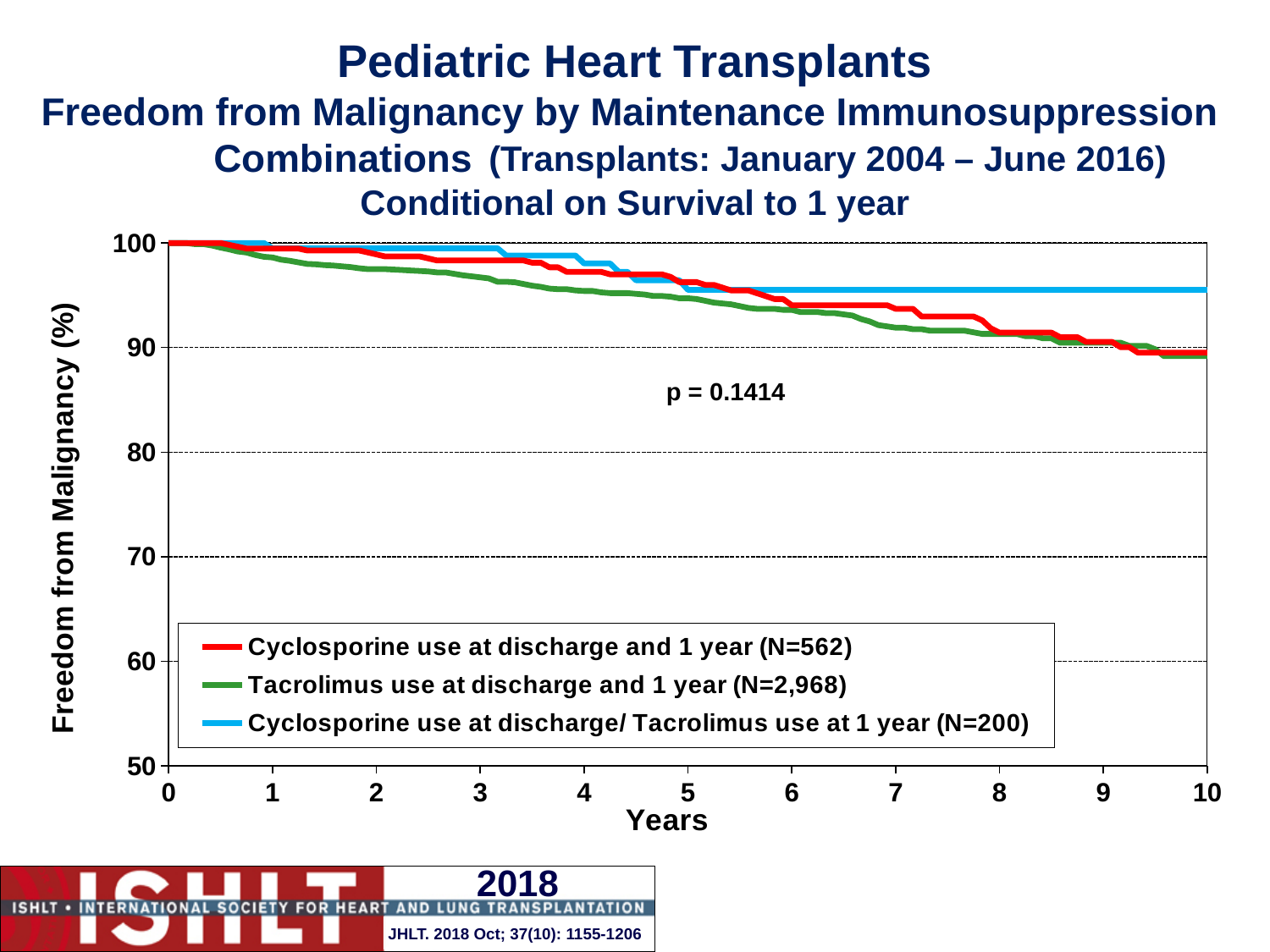
At 8 years, which is higher: the Cyclosporine use at discharge/ Tacrolimus use at 1 year curve or the Tacrolimus use at discharge and 1 year curve? Cyclosporine use at discharge/ Tacrolimus use at 1 year What is the N for the Tacrolimus use at discharge and 1 year group? N=2,968 Which series has the lowest freedom from malignancy at 10 years? Tacrolimus use at discharge and 1 year (N=2,968) How many series does the legend list? 3 What is the label of the x axis? Years Is the freedom from malignancy for the Tacrolimus use at discharge and 1 year group at 10 years greater or less than 90? less What kind of chart is shown on the slide? line chart Do the freedom from malignancy curves rise or fall as years increase? fall What p-value is printed on the chart? p = 0.1414 Is the freedom from malignancy for the Cyclosporine use at discharge/ Tacrolimus use at 1 year group at 10 years greater or less than 90? greater Which series has the highest freedom from malignancy at 10 years? Cyclosporine use at discharge/ Tacrolimus use at 1 year (N=200) Is the freedom from malignancy for the Tacrolimus use at discharge and 1 year group at 5 years greater or less than 90? greater